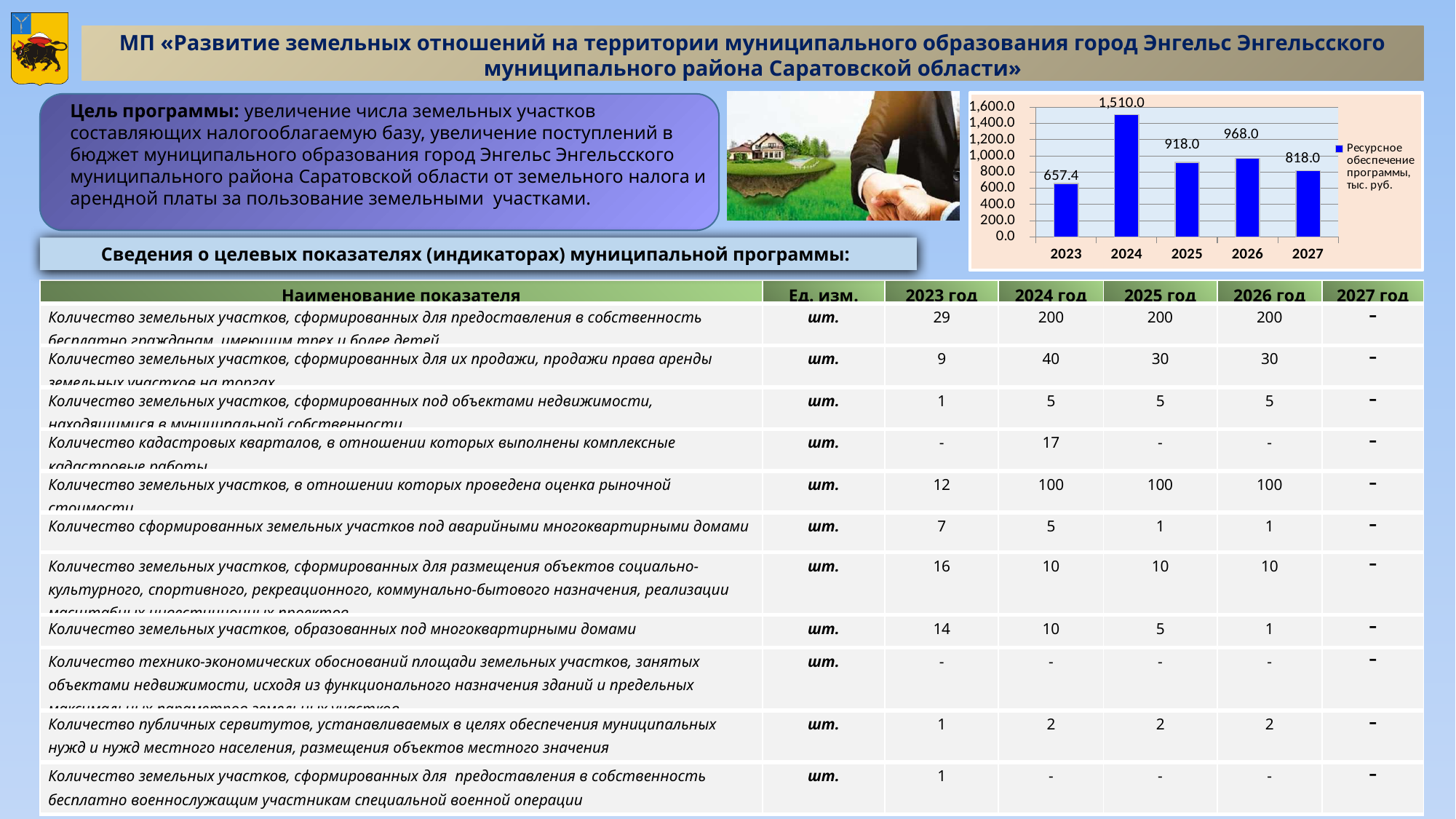
What kind of chart is shown on the slide? bar chart What is the value for 2027 in the chart? 818.0 Which year has the lowest value in the chart? 2023 Is the value for 2027 in the chart greater or less than 1,000.0? less How many years are shown on the x axis of the chart? 5 What is the value for 2024 in the chart? 1,510.0 What is the value for 2023 in the chart? 657.4 How many series does the chart legend list? 1 Which is larger in the chart, the value for 2026 or the value for 2025? 2026 Which year has the highest value in the chart? 2024 What is the difference between the values for 2024 and 2025 in the chart? 592.0 What is the legend entry of the chart? Ресурсное обеспечение программы, тыс. руб.